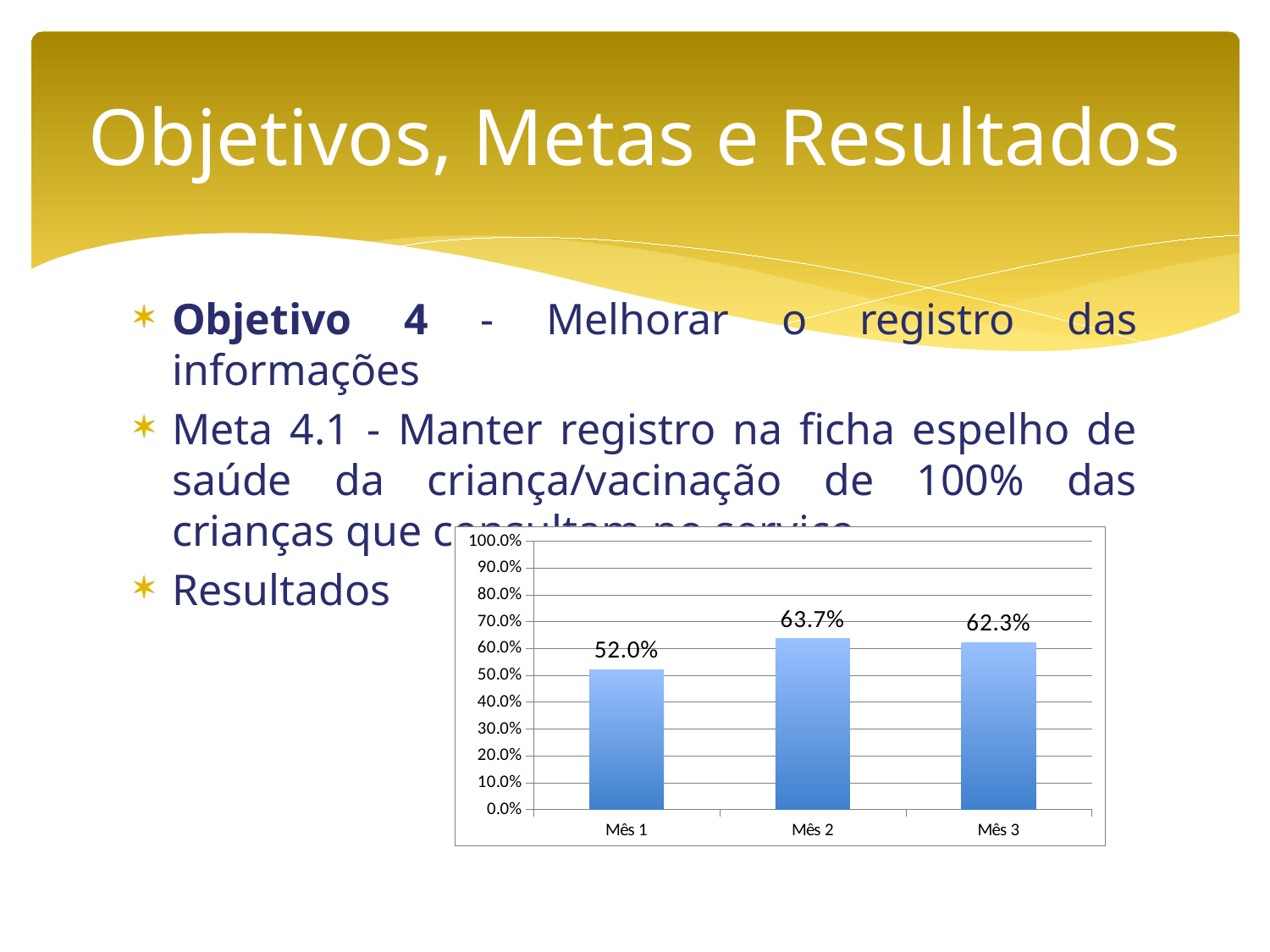
What is the difference between the values for Mês 2 and Mês 1? 11.7% Which month has the lowest value? Mês 1 What kind of chart is shown on the slide? bar chart Which month has the highest value? Mês 2 What is the difference between the values for Mês 2 and Mês 3? 1.4% How many months are shown on the x axis? 3 What is the value for Mês 1? 52.0% Which is larger, the value for Mês 1 or the value for Mês 3? Mês 3 What is the value for Mês 3? 62.3% What is the value for Mês 2? 63.7% Is the value for Mês 1 greater or less than 60.0%? less What is the maximum value shown on the y axis? 100.0%